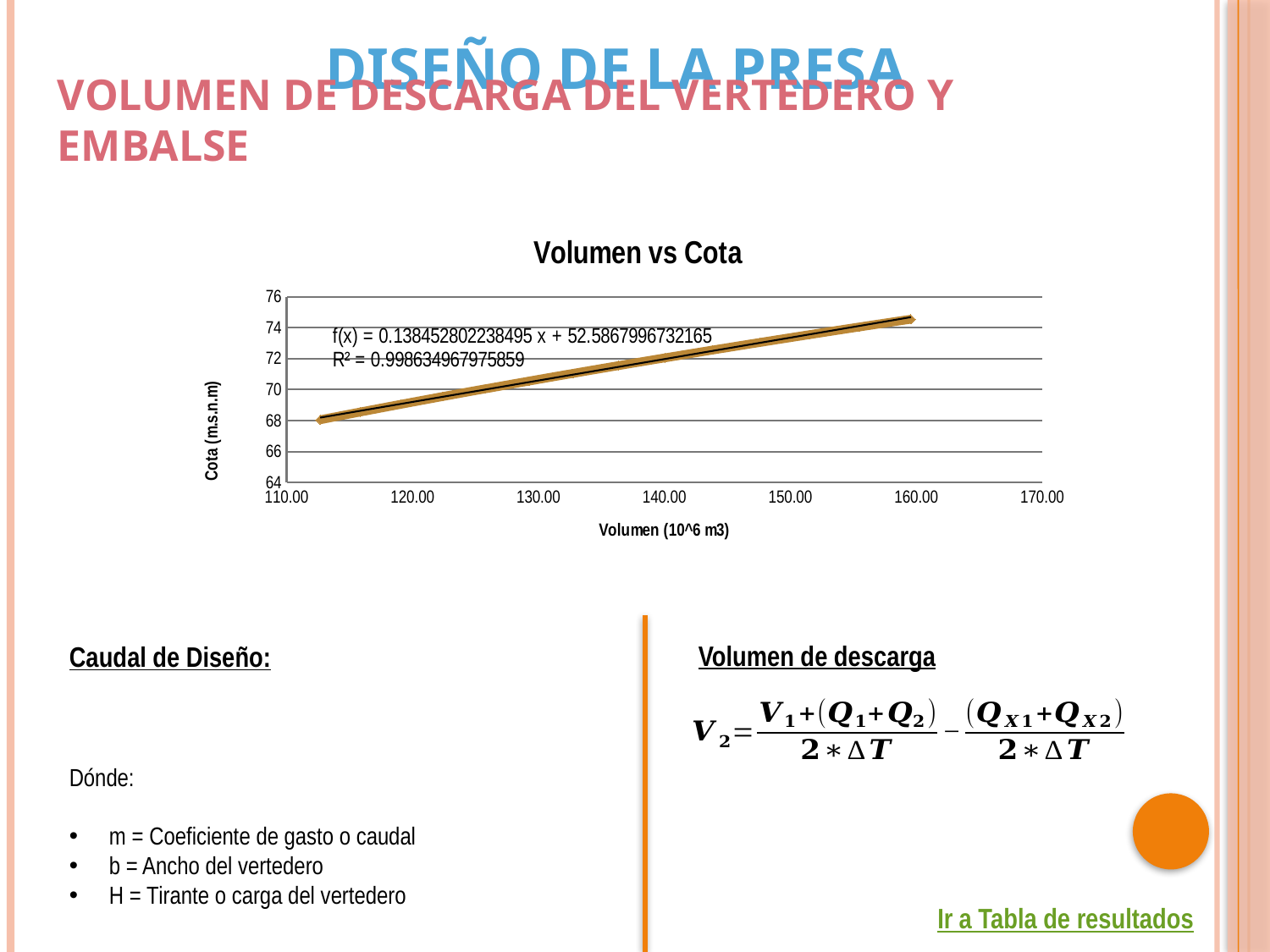
What is the highest tick value shown on the y axis of the chart? 76 Is the Cota value at the left end of the line (near Volumen 110–115) greater or less than 70? less Is the Cota value at the left end of the line (near Volumen 110–115) greater or less than 66? greater Is the Cota value at the right end of the line (near Volumen 160) greater or less than 76? less What kind of chart is shown on the slide? line chart What is the title of the chart on the slide? Volumen vs Cota Does the Cota value rise or fall as Volumen increases along the x axis? rise What trendline equation is printed on the chart? f(x) = 0.138452802238495 x + 52.5867996732165 What R² value is printed on the chart? R² = 0.998634967975859 Which end of the line has the higher Cota value, the end near Volumen 110 or the end near Volumen 160? the end near Volumen 160 What is the label of the y axis of the chart? Cota (m.s.n.m)